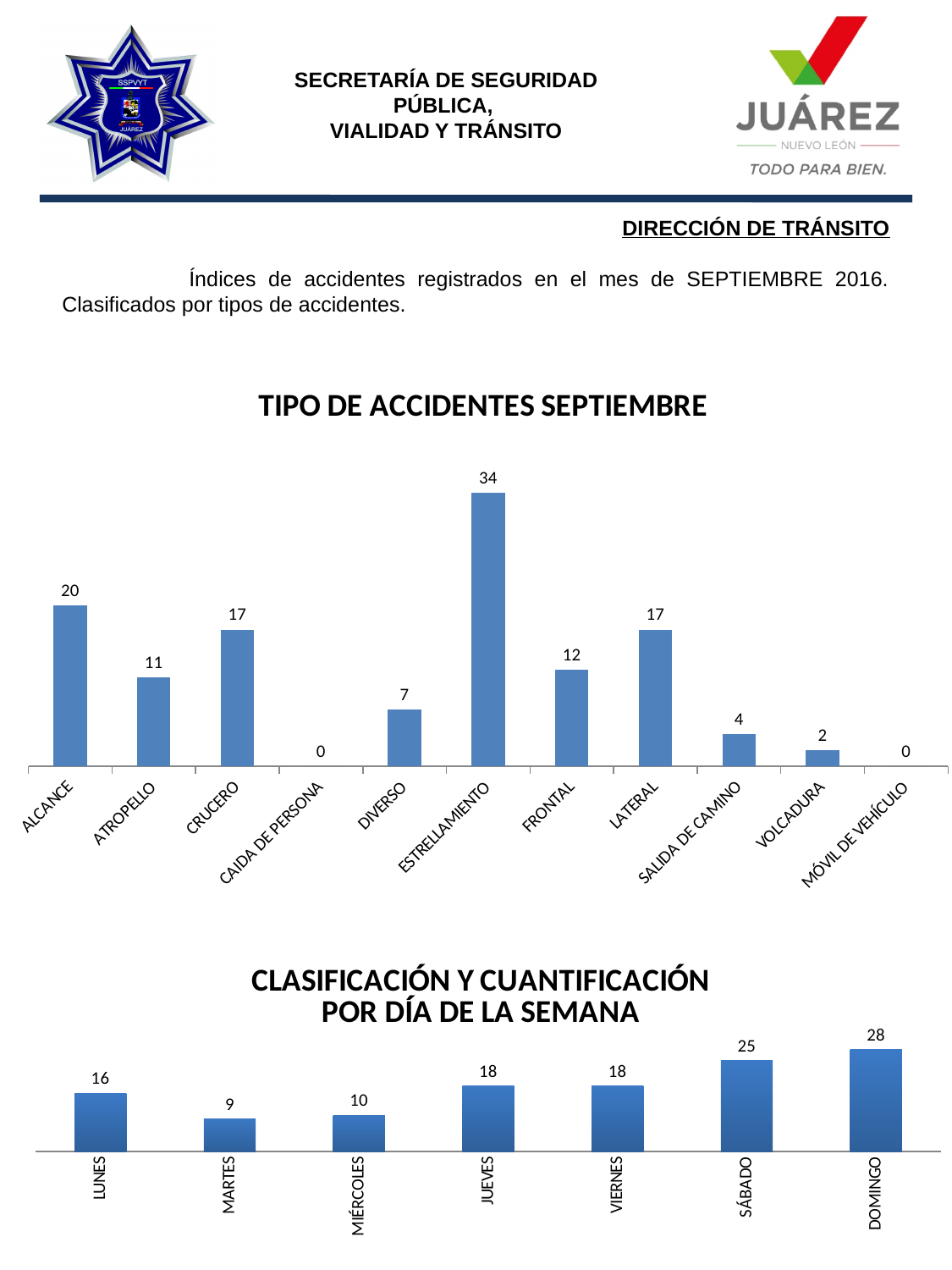
In the 'TIPO DE ACCIDENTES SEPTIEMBRE' chart, what is the difference between ALCANCE and FRONTAL? 8 In the 'TIPO DE ACCIDENTES SEPTIEMBRE' chart, which is larger, DIVERSO or SALIDA DE CAMINO? DIVERSO In the 'TIPO DE ACCIDENTES SEPTIEMBRE' chart, which category has the highest value? ESTRELLAMIENTO In the 'TIPO DE ACCIDENTES SEPTIEMBRE' chart, what is the value for ATROPELLO? 11 In the 'CLASIFICACIÓN Y CUANTIFICACIÓN POR DÍA DE LA SEMANA' chart, do the values rise or fall from VIERNES to DOMINGO? Rise In the 'CLASIFICACIÓN Y CUANTIFICACIÓN POR DÍA DE LA SEMANA' chart, what is the value for SÁBADO? 25 How many days are shown in the 'CLASIFICACIÓN Y CUANTIFICACIÓN POR DÍA DE LA SEMANA' chart? 7 What kind of chart is the 'TIPO DE ACCIDENTES SEPTIEMBRE' chart? Bar chart In the 'CLASIFICACIÓN Y CUANTIFICACIÓN POR DÍA DE LA SEMANA' chart, what is the difference between DOMINGO and LUNES? 12 How many categories are shown in the 'TIPO DE ACCIDENTES SEPTIEMBRE' chart? 11 In the 'TIPO DE ACCIDENTES SEPTIEMBRE' chart, what is the value for ESTRELLAMIENTO? 34 In the 'CLASIFICACIÓN Y CUANTIFICACIÓN POR DÍA DE LA SEMANA' chart, which day has the lowest value? MARTES